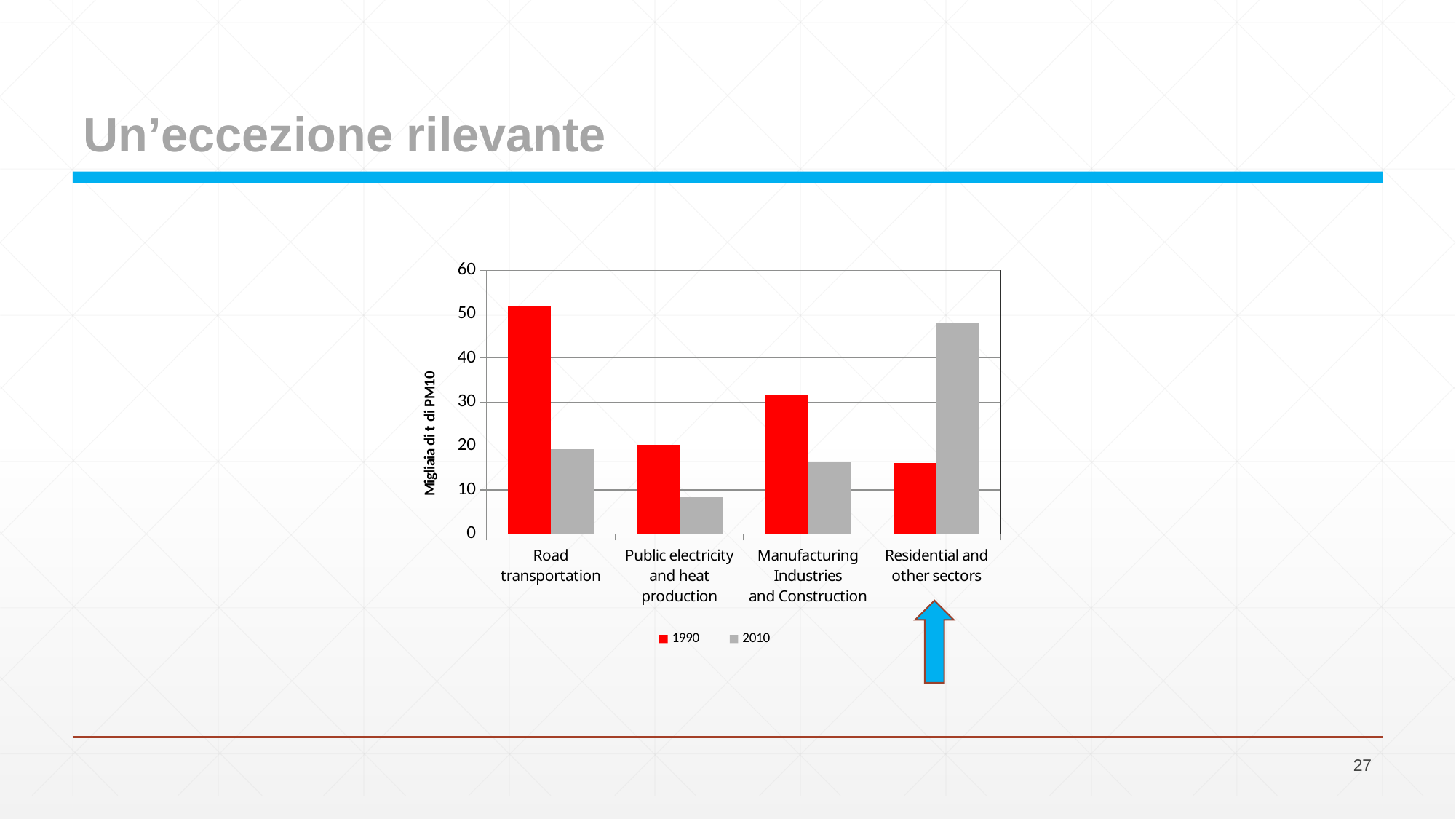
What kind of chart is shown on the slide? bar chart How many categories are shown on the x axis of the chart? 4 Is the 2010 value for Residential and other sectors greater or less than 40? greater What is the label on the vertical axis of the chart? Migliaia di t di PM10 Which category has the highest value for the 1990 series? Road transportation For Road transportation, which series has the larger value, 1990 or 2010? 1990 Which category has the lowest value for the 2010 series? Public electricity and heat production Which category has the highest value for the 2010 series? Residential and other sectors For Residential and other sectors, which series has the larger value, 1990 or 2010? 2010 How many series does the chart's legend list? 2 Is the 1990 value for Road transportation greater or less than 40? greater Is the 2010 value for Public electricity and heat production greater or less than 10? less